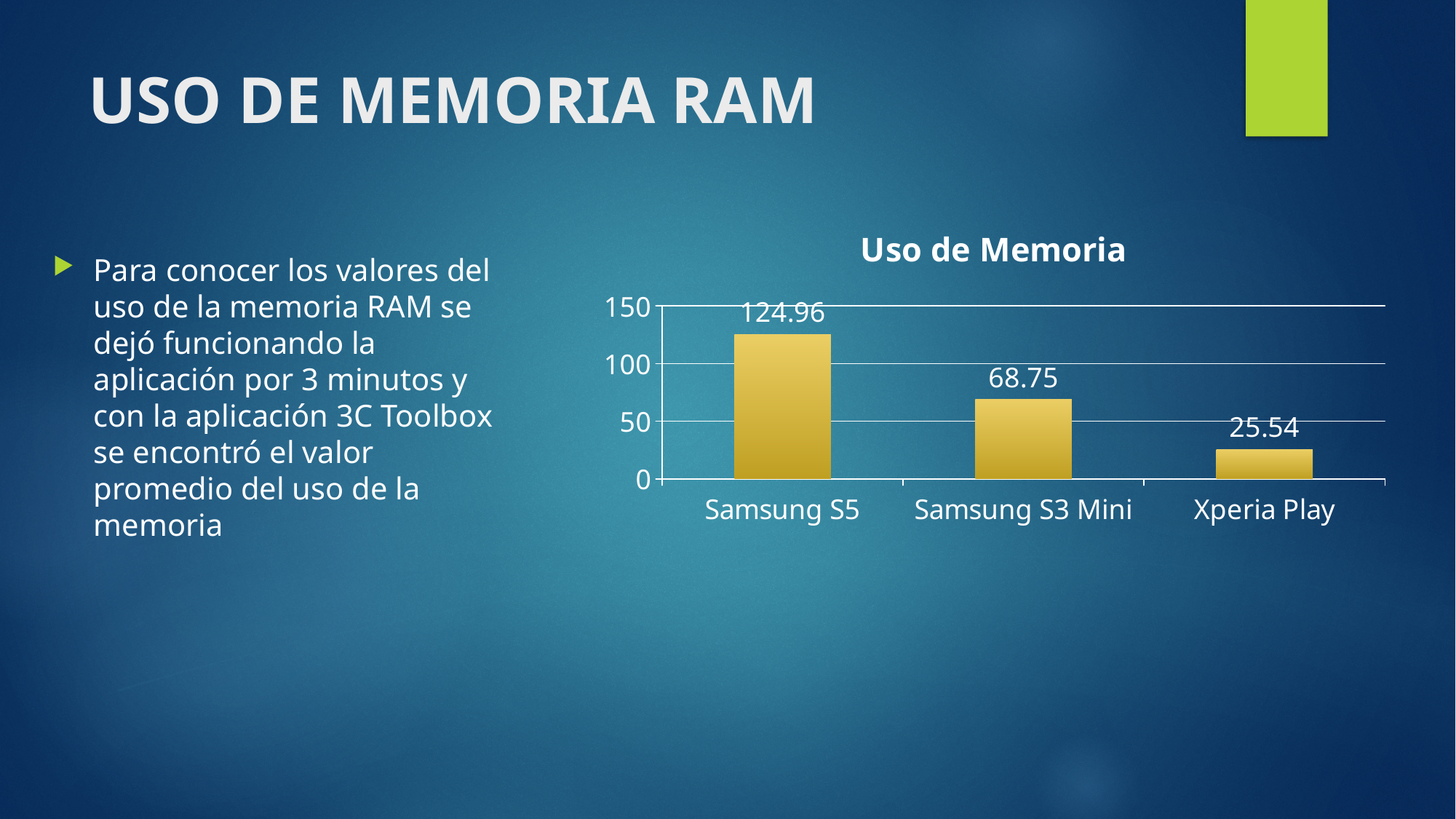
Which is larger, the value for Samsung S3 Mini or the value for Xperia Play? Samsung S3 Mini What is the difference between the values for Samsung S3 Mini and Xperia Play? 43.21 What is the value for Xperia Play in the Uso de Memoria chart? 25.54 What is the title of the chart? Uso de Memoria How many devices are shown in the chart? 3 Is the value for Samsung S5 greater or less than 100? greater What is the value for Samsung S3 Mini in the Uso de Memoria chart? 68.75 What kind of chart is shown on the slide? bar chart Which device has the highest memory usage in the chart? Samsung S5 Which device has the lowest memory usage in the chart? Xperia Play What is the difference between the values for Samsung S5 and Samsung S3 Mini? 56.21 What is the value for Samsung S5 in the Uso de Memoria chart? 124.96